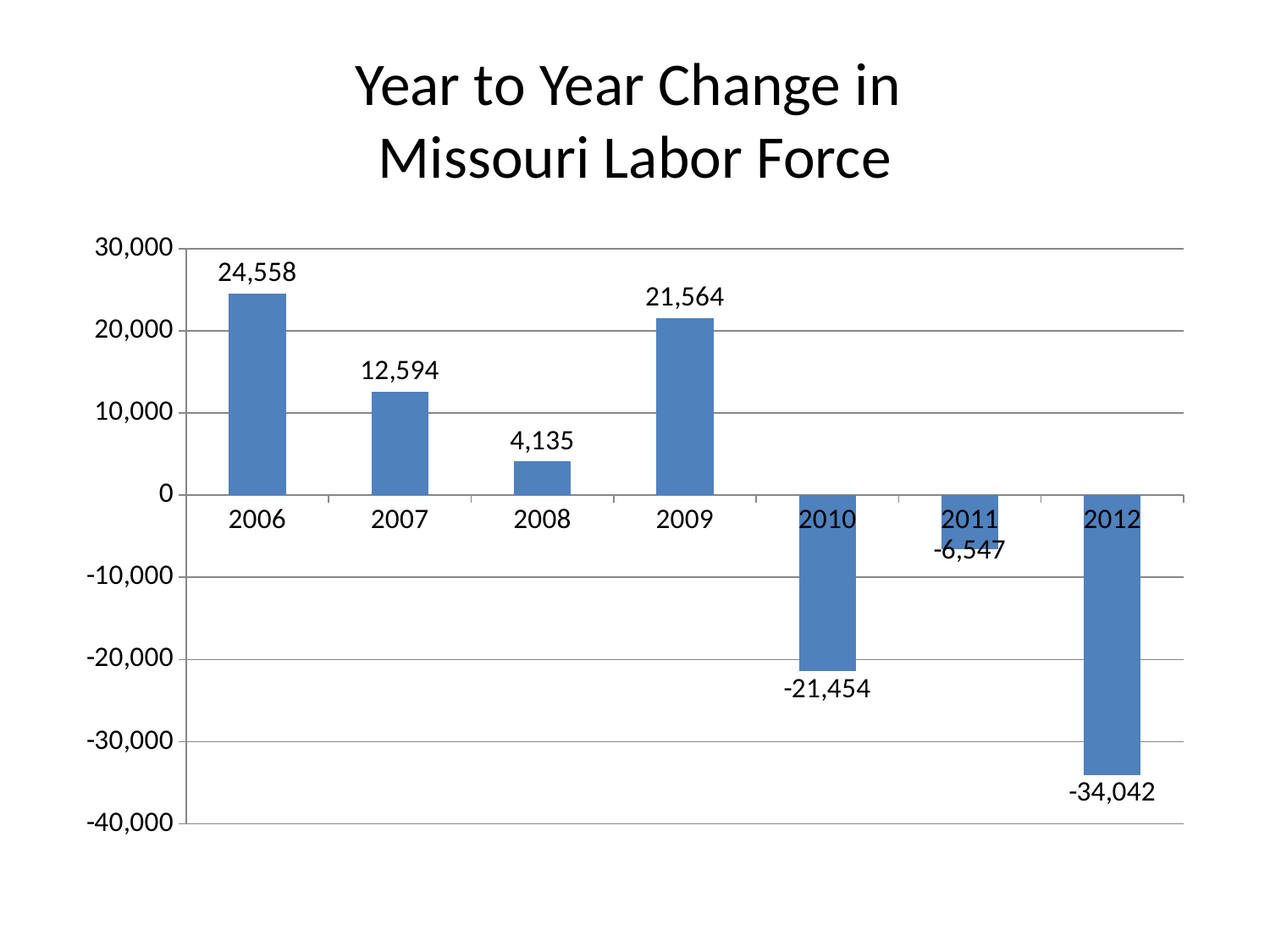
What is the value shown for 2012? -34,042 How many years are shown on the chart? 7 What is the difference between the values for 2006 and 2009? 2,994 What is the year to year change in Missouri labor force for 2006? 24,558 Is the value for 2010 greater or less than -20,000? less What kind of chart is shown on the slide? bar chart What is the title of the chart? Year to Year Change in Missouri Labor Force What is the difference between the values for 2007 and 2008? 8,459 Which year has the lowest value? 2012 What is the value shown for 2011? -6,547 Which year has the highest value? 2006 Which is larger, the value for 2007 or the value for 2009? 2009